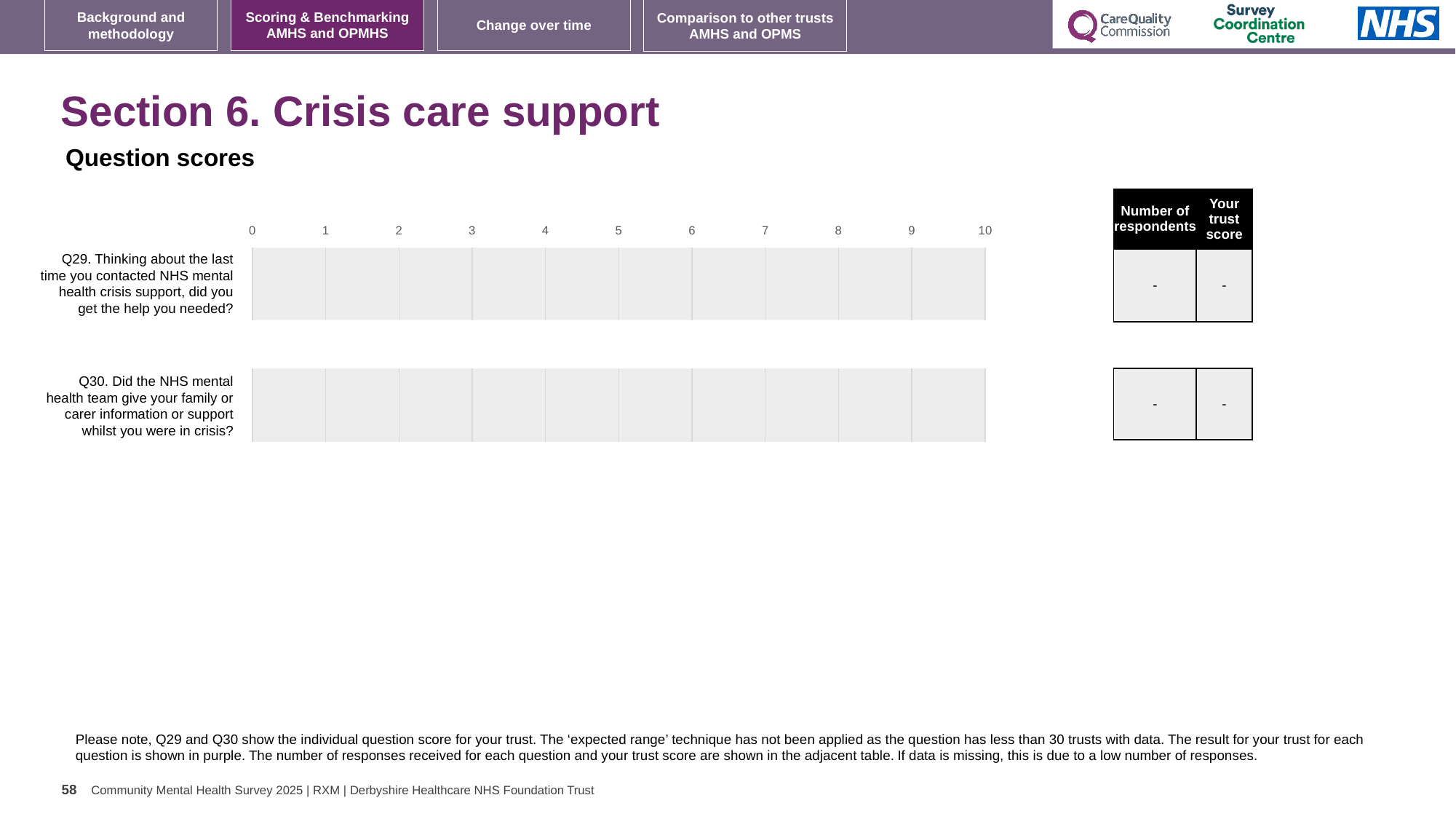
What is the highest value shown on the chart's axis? 10 What trust score is shown in the table for Q30? - What trust score is shown in the table for Q29? - What number of respondents is shown in the table for Q30? - Which question number is listed second on the chart? Q30 What kind of chart is used to display the question scores? bar chart What is the lowest value shown on the chart's axis? 0 What number of respondents is shown in the table for Q29? - Which question number is listed first (at the top) on the chart? Q29 How many questions (categories) are shown on the chart? 2